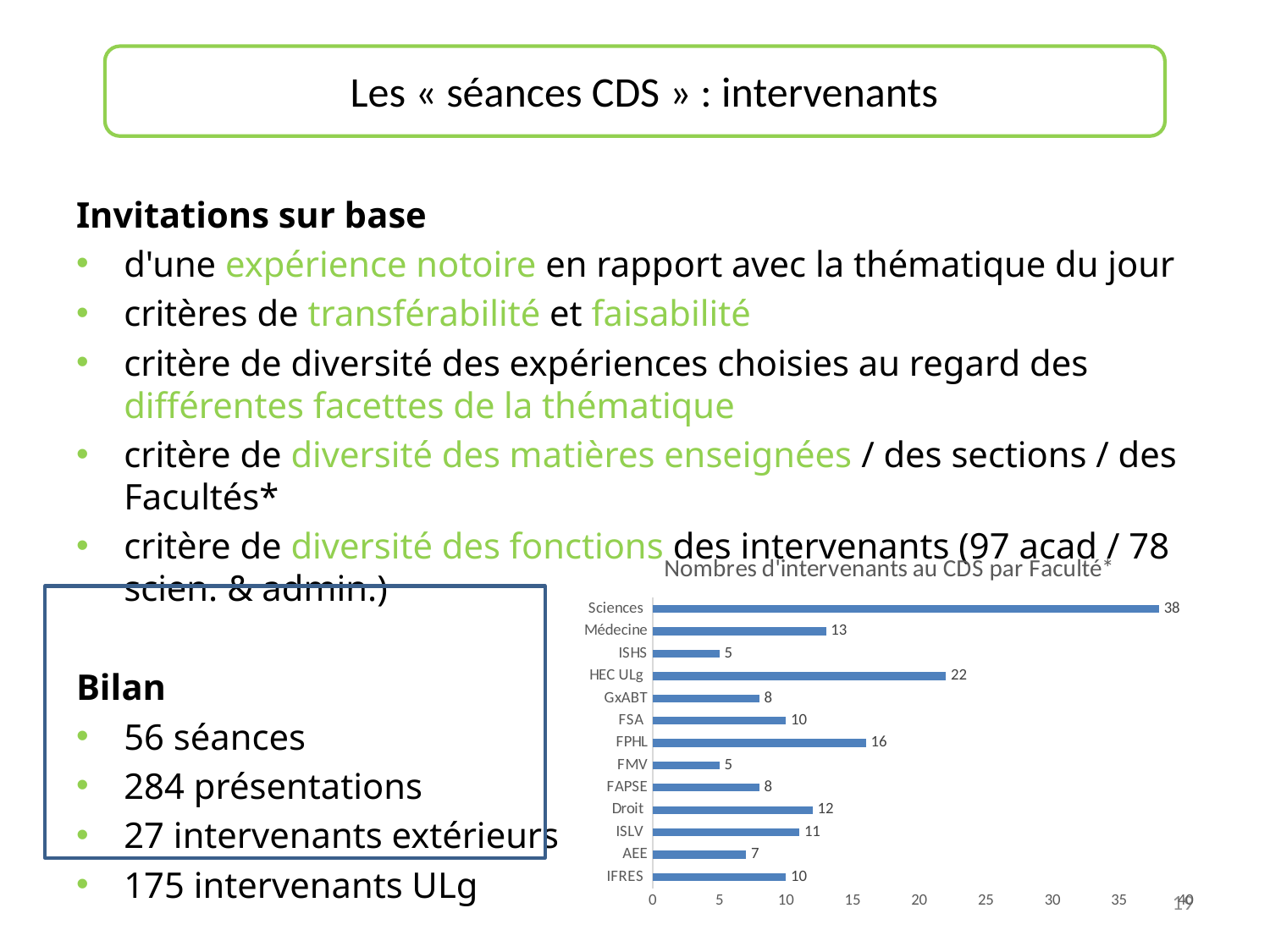
How many faculties (categories) are shown in the chart? 13 What is the difference between the values for Médecine and ISLV? 2 What type of chart is used to show the number of intervenants per faculty? Bar chart What is the value for Sciences in the chart? 38 Which has a larger value, FPHL or Médecine? FPHL Which faculty has the highest number of intervenants in the chart? Sciences Which faculties share the lowest value in the chart? ISHS and FMV What is the value for Droit in the chart? 12 What is the difference between the values for Sciences and HEC ULg? 16 What is the title of the chart on the slide? Nombres d'intervenants au CDS par Faculté* How many intervenants does the chart show for HEC ULg? 22 What is the value for FPHL in the chart? 16